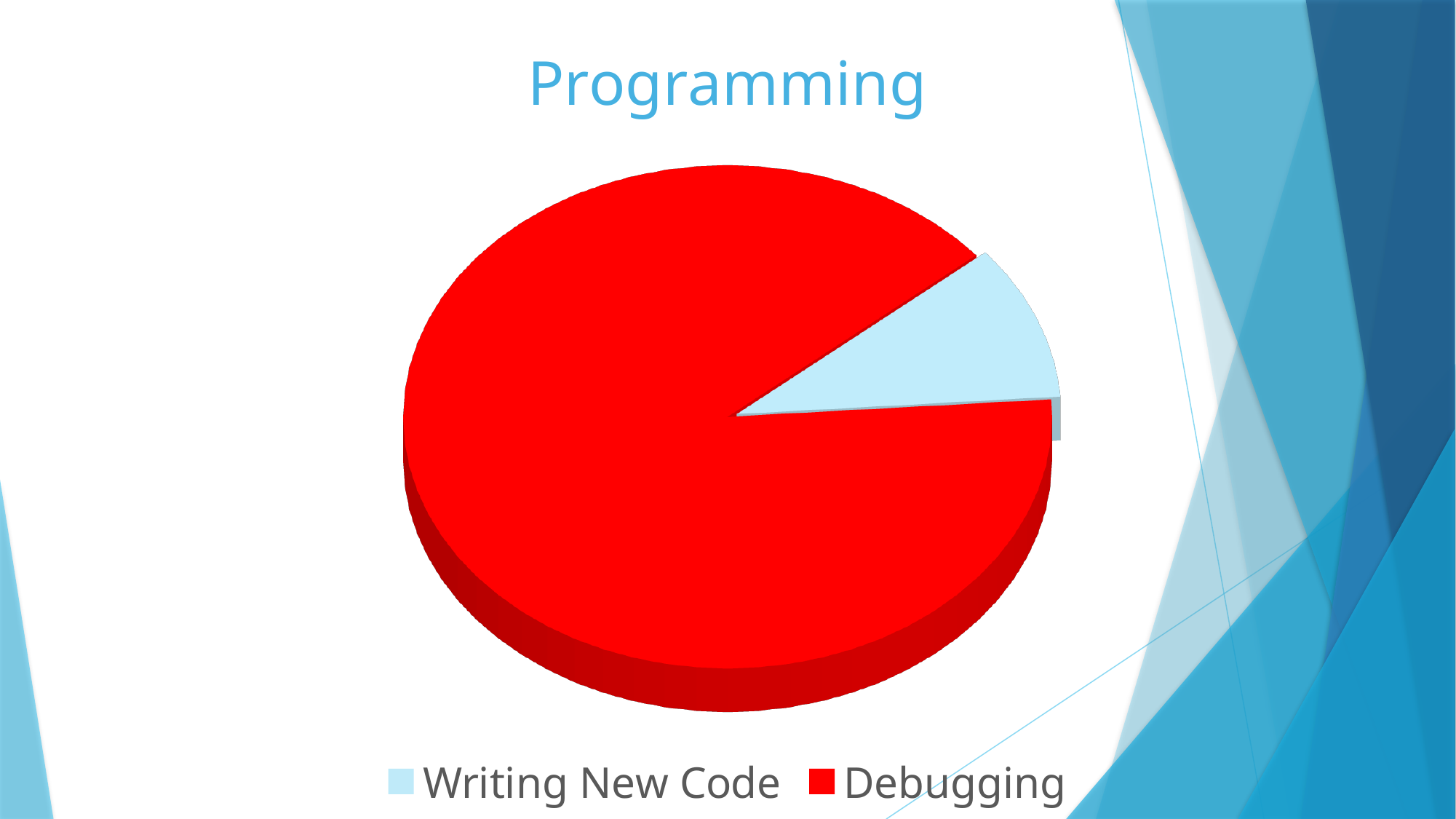
How many entries does the legend list? 2 Which slice is the largest in the pie chart? Debugging What colour is the Debugging slice? red How many slices does the pie chart have? 2 What is the title of the chart? Programming What kind of chart is shown on the slide? pie chart Which legend entry is shown in light blue? Writing New Code Which slice is the smallest in the pie chart? Writing New Code Which is larger, the Debugging slice or the Writing New Code slice? Debugging